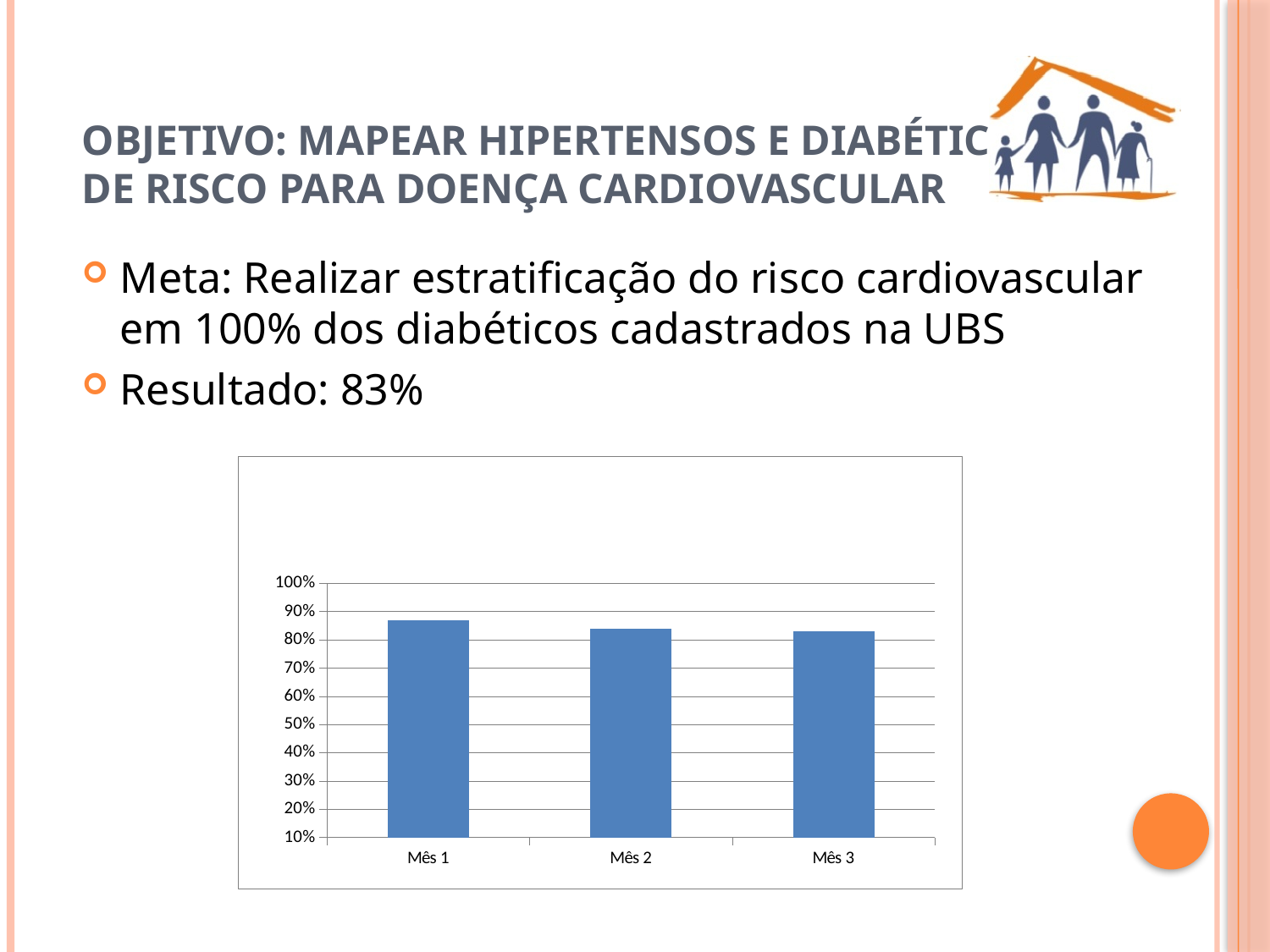
Is the value for Mês 1 greater or less than 80%? greater Which is larger, the value for Mês 1 or the value for Mês 3? Mês 1 Which month has the highest bar on the chart? Mês 1 Do the values rise or fall from Mês 1 to Mês 3? fall What is the highest tick label shown on the vertical axis of the chart? 100% Is the value for Mês 3 greater or less than 70%? greater How many categories (months) are plotted on the chart? 3 What kind of chart is shown on the slide? bar chart Is the value for Mês 2 greater or less than 60%? greater What are the category labels on the horizontal axis of the chart? Mês 1, Mês 2, Mês 3